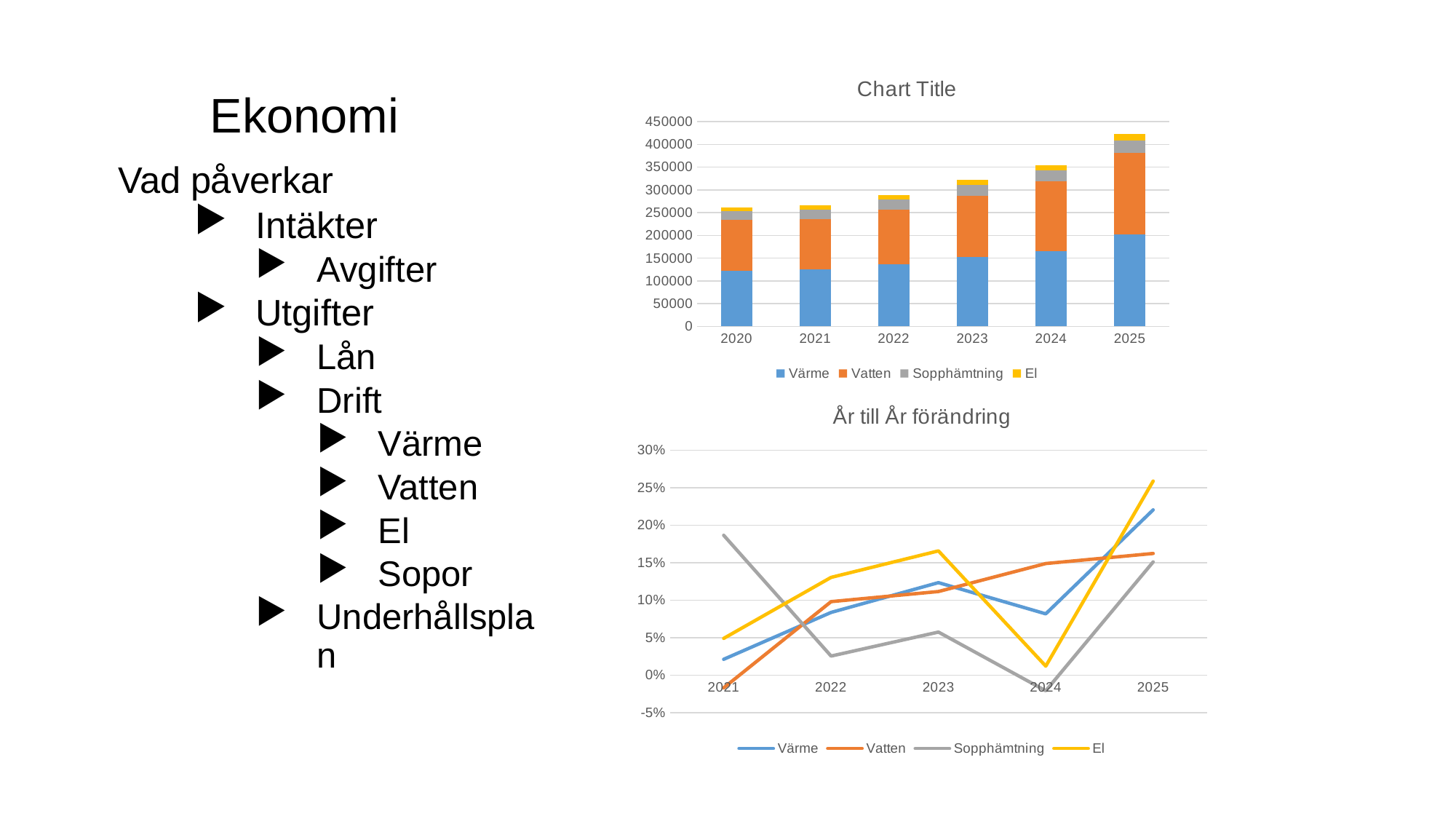
In the top chart titled "Chart Title", which year has the highest total bar? 2025 In the bottom chart titled "År till År förändring", is the value for Sopphämtning in 2021 greater or less than 15%? greater In the bottom chart titled "År till År förändring", which series has the lowest value in 2024? Sopphämtning What kind of chart is the bottom chart titled "År till År förändring"? line chart In the top chart titled "Chart Title", how many years are shown on the x axis? 6 In the top chart titled "Chart Title", is the total for 2020 greater or less than 300000? less In the top chart titled "Chart Title", do the total bar heights rise or fall from 2020 to 2025? rise In the top chart titled "Chart Title", is the total for 2025 greater or less than 400000? greater What kind of chart is the top chart titled "Chart Title"? stacked bar chart In the bottom chart titled "År till År förändring", which series has the highest value in 2025? El In the bottom chart titled "År till År förändring", how many series does the legend list? 4 In the bottom chart titled "År till År förändring", which is larger in 2024, Vatten or El? Vatten